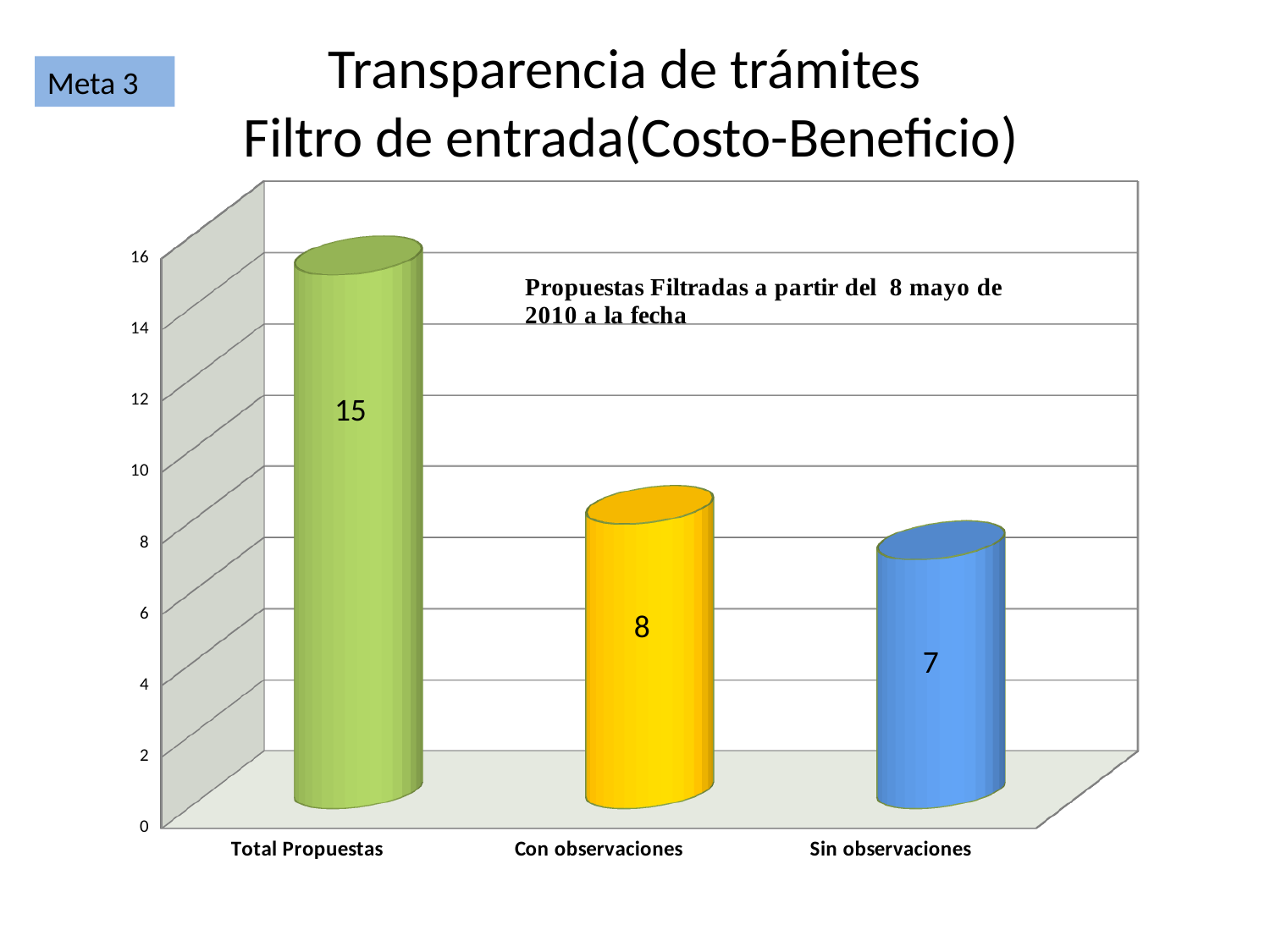
What is the difference between Total Propuestas and Con observaciones? 7 What is the difference between Con observaciones and Sin observaciones? 1 Which category has the lowest value? Sin observaciones Is the value for Total Propuestas greater or less than 10? greater Which category has the highest value? Total Propuestas What is the value for Con observaciones? 8 How many categories are shown on the chart? 3 What is the value for Sin observaciones? 7 What kind of chart is shown on the slide? bar chart What text label appears inside the chart area? Propuestas Filtradas a partir del 8 mayo de 2010 a la fecha What is the value for Total Propuestas? 15 Which is larger, Con observaciones or Sin observaciones? Con observaciones